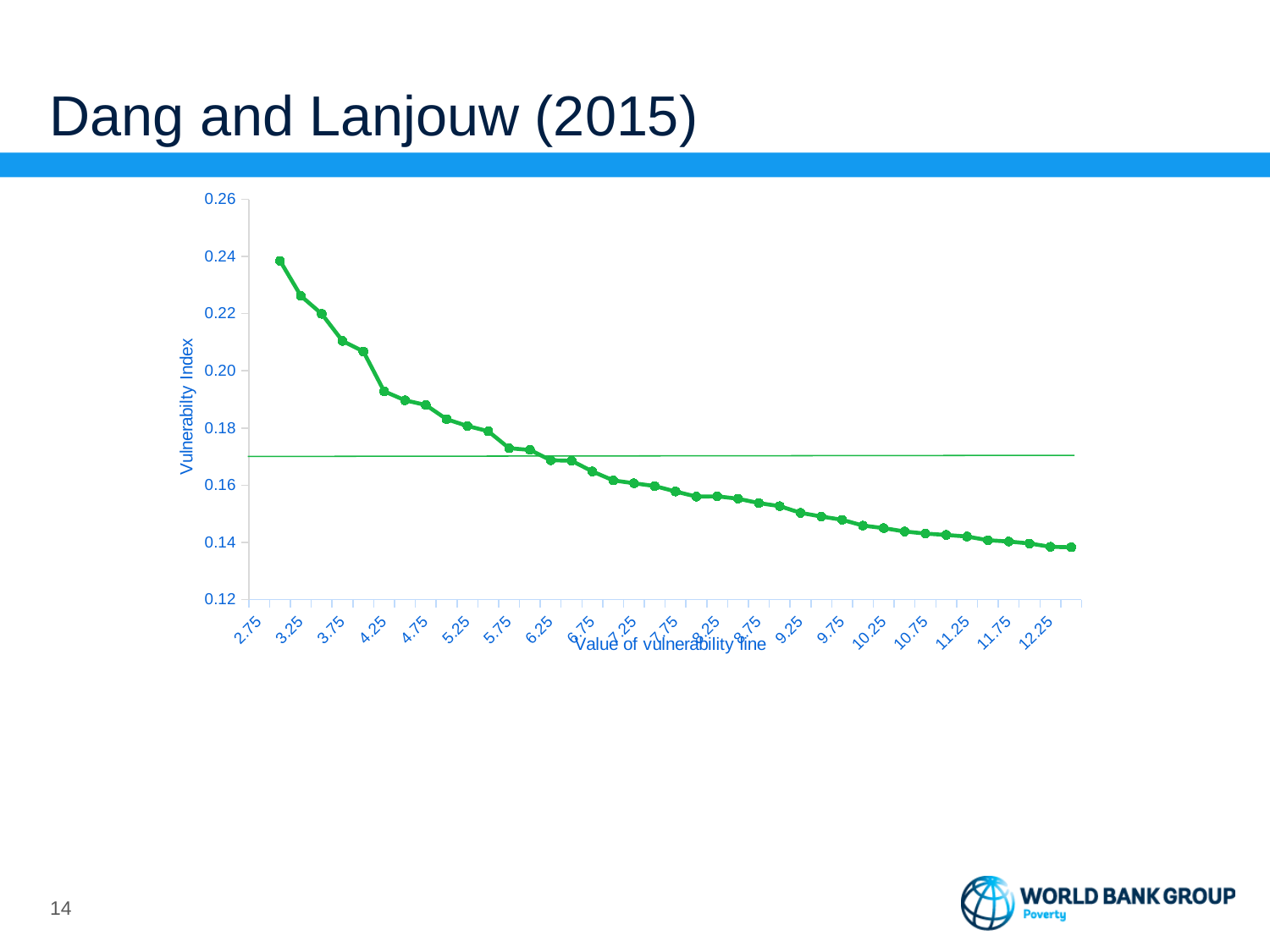
Does the Vulnerability Index rise or fall as the value of the vulnerability line increases? fall Is the Vulnerability Index at a vulnerability line of 4.25 greater or less than 0.18? greater Is the Vulnerability Index at a vulnerability line of 9.25 greater or less than 0.16? less Is the Vulnerability Index at a vulnerability line of 3.25 greater or less than 0.20? greater What is the title of the x axis? Value of vulnerability line What kind of chart is shown on the slide? line chart How many labels are shown on the x axis? 20